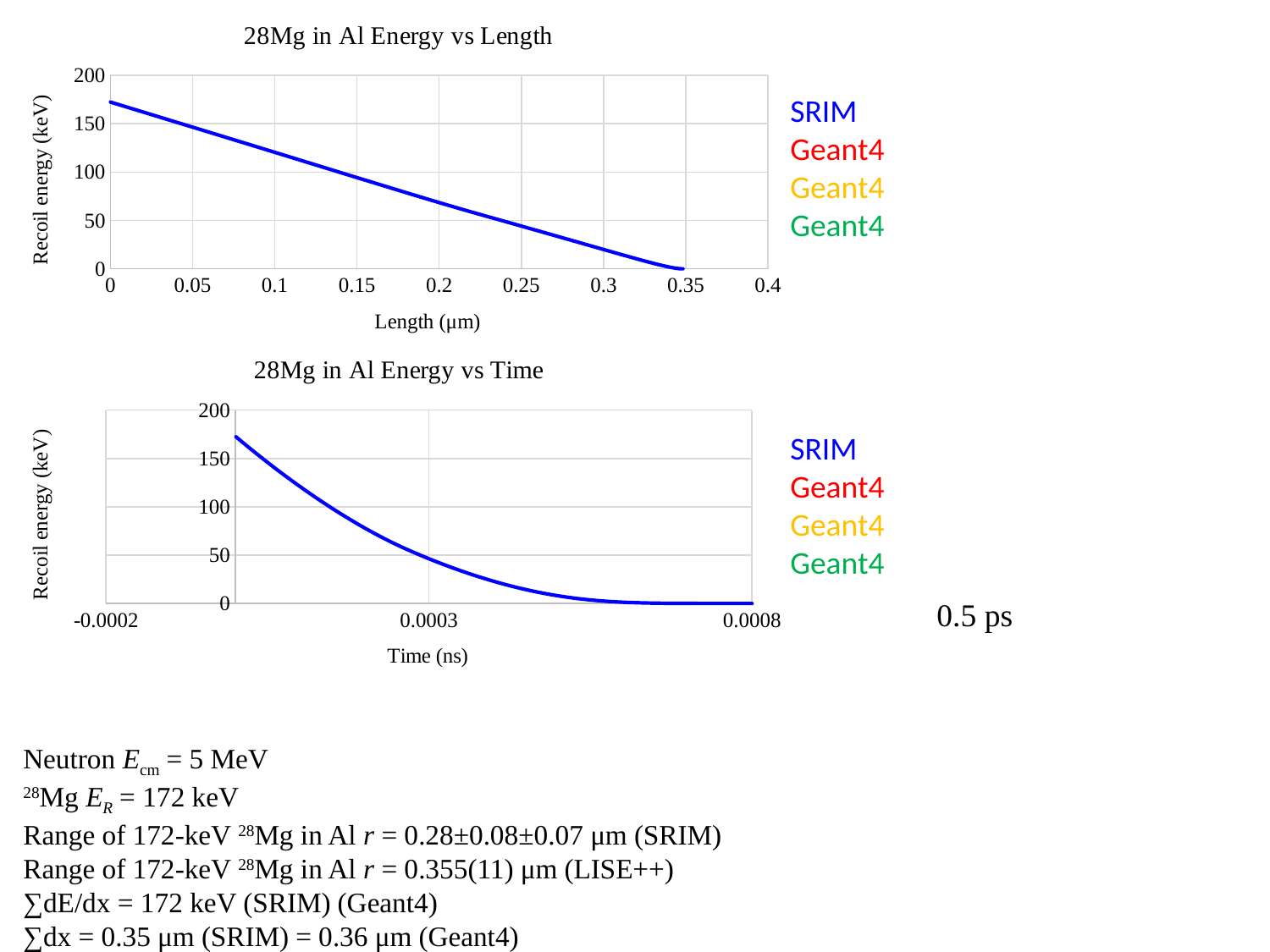
What kind of chart is the '28Mg in Al Energy vs Length' chart? line chart In the '28Mg in Al Energy vs Length' chart, is the recoil energy at a length of 0.2 µm greater or less than 100 keV? less In the '28Mg in Al Energy vs Length' chart, does the recoil energy rise or fall as length increases? fall In the '28Mg in Al Energy vs Length' chart, is the recoil energy at a length of 0.3 µm greater or less than 50 keV? less What kind of chart is the '28Mg in Al Energy vs Time' chart? line chart In the '28Mg in Al Energy vs Time' chart, does the recoil energy rise or fall as time increases? fall In the '28Mg in Al Energy vs Time' chart, is the recoil energy at a time of 0.0008 ns greater or less than 50 keV? less What is the x-axis label of the '28Mg in Al Energy vs Time' chart? Time (ns) In the '28Mg in Al Energy vs Length' chart, what colour is the SRIM legend entry? blue How many entries does the legend of the '28Mg in Al Energy vs Length' chart list? 4 How many entries does the legend of the '28Mg in Al Energy vs Time' chart list? 4